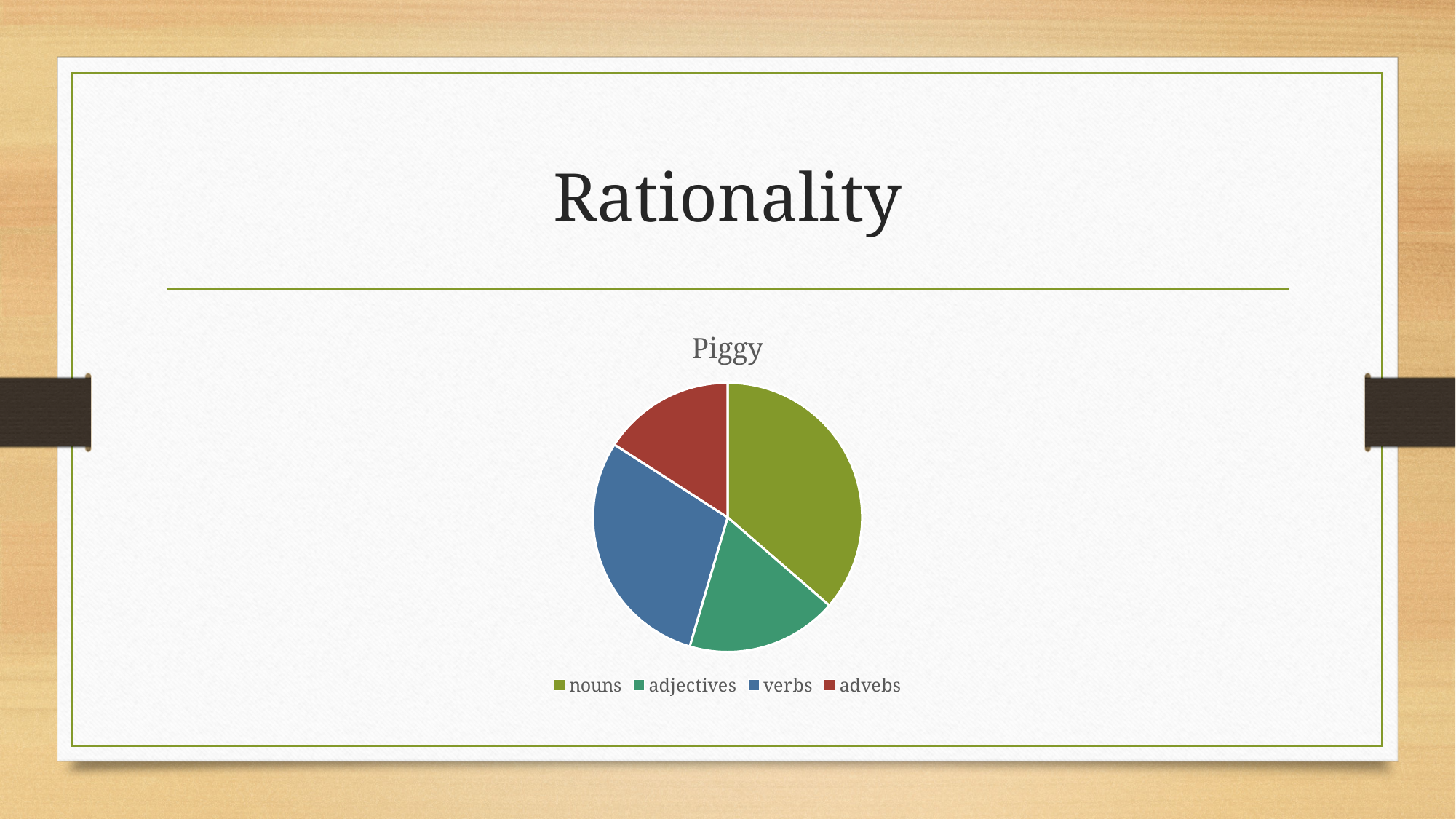
What is the title of the chart? Piggy What kind of chart is shown on the slide? pie chart How many entries does the legend list? 4 Which slice is larger, nouns or adjectives? nouns Which slice is larger, nouns or verbs? nouns Which slice is larger, verbs or adjectives? verbs Which category has the largest slice of the pie? nouns How many slices does the pie chart have? 4 What colour is the slice for verbs? blue